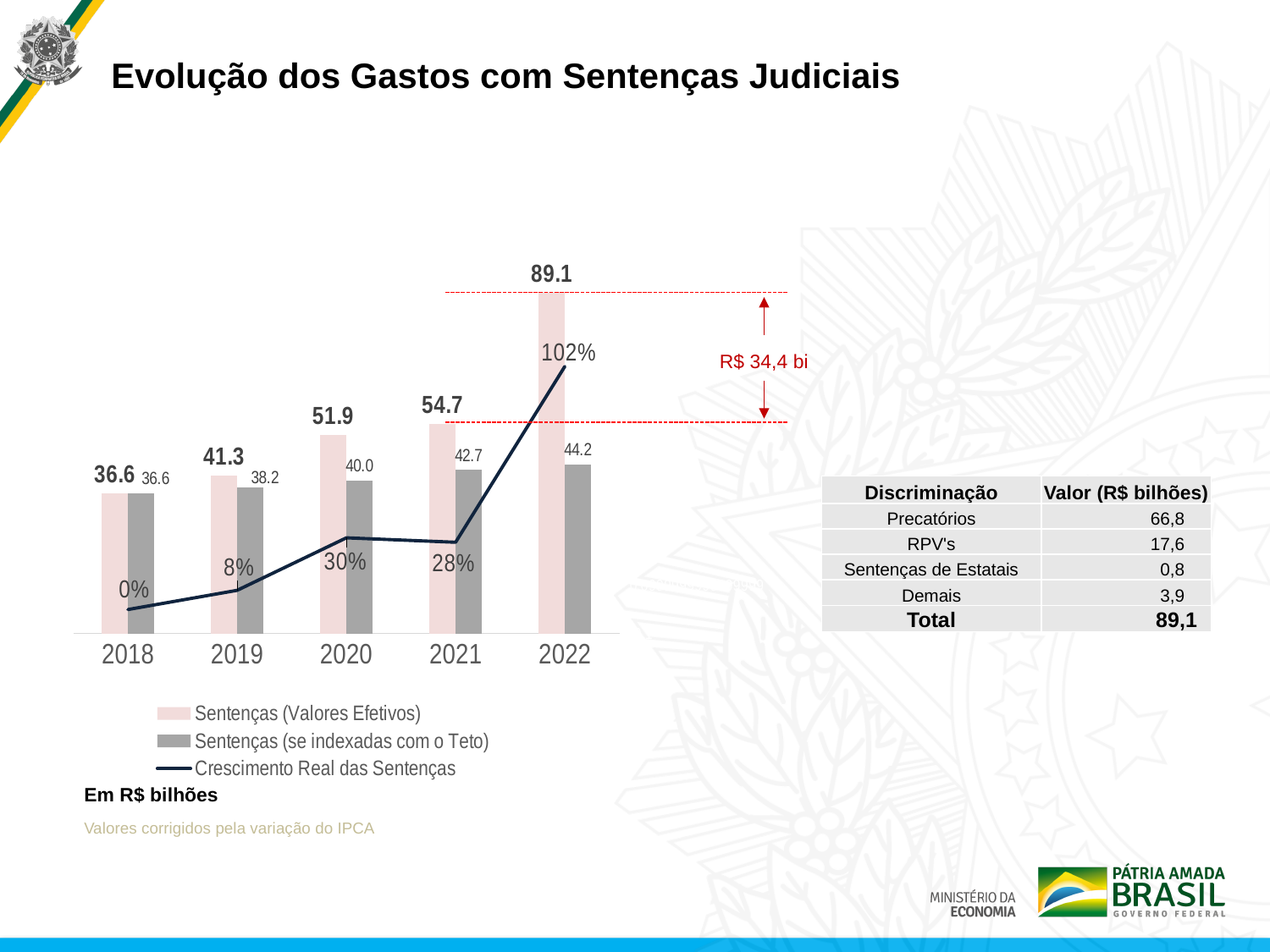
Do the values of Sentenças (Valores Efetivos) rise or fall from 2018 to 2022? Rise Which year has the lowest value for Sentenças (se indexadas com o Teto)? 2018 Which is larger in 2019: Sentenças (Valores Efetivos) or Sentenças (se indexadas com o Teto)? Sentenças (Valores Efetivos) What kind of chart is shown on the slide? Combined bar and line chart What is the Crescimento Real das Sentenças value for 2020? 30% What is the value of Sentenças (se indexadas com o Teto) for 2021? 42.7 What is the difference between Sentenças (Valores Efetivos) and Sentenças (se indexadas com o Teto) in 2022? 44.9 Which year has the highest value for Sentenças (Valores Efetivos)? 2022 What is the title of the chart on the slide? Evolução dos Gastos com Sentenças Judiciais How many series does the chart legend list? 3 How many years are shown on the x axis of the chart? 5 What is the value of Sentenças (Valores Efetivos) for 2022? 89.1